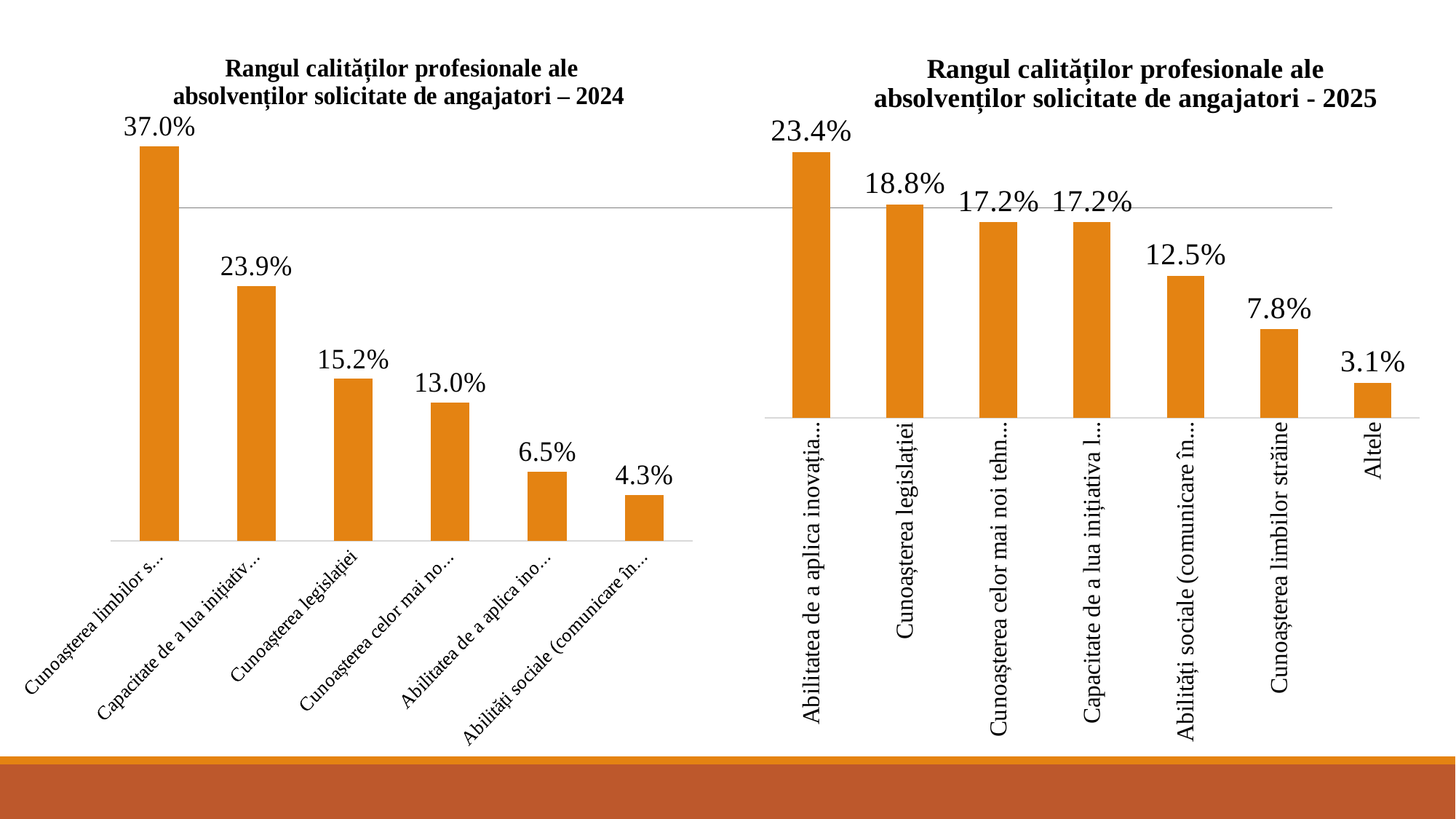
What type of chart is the 2024 chart? Bar chart In the 2025 chart, what is the difference between the values for Cunoașterea legislației and Altele? 15.7% How many bars are in the 2024 chart? 6 In the 2025 chart, what is the value for Cunoașterea limbilor străine? 7.8% How many bars are in the 2025 chart? 7 In the 2024 chart, what is the value for Cunoașterea legislației? 15.2% In the 2025 chart, what is the value for Altele? 3.1% In the 2024 chart, what is the value of the highest bar? 37.0% What is the difference between the values for Cunoașterea legislației in the 2025 chart and in the 2024 chart? 3.6% Which is larger: the value for Cunoașterea legislației in the 2024 chart or in the 2025 chart? 2025 In the 2025 chart, which category has the lowest value? Altele In the 2025 chart, what is the value for Cunoașterea legislației? 18.8%